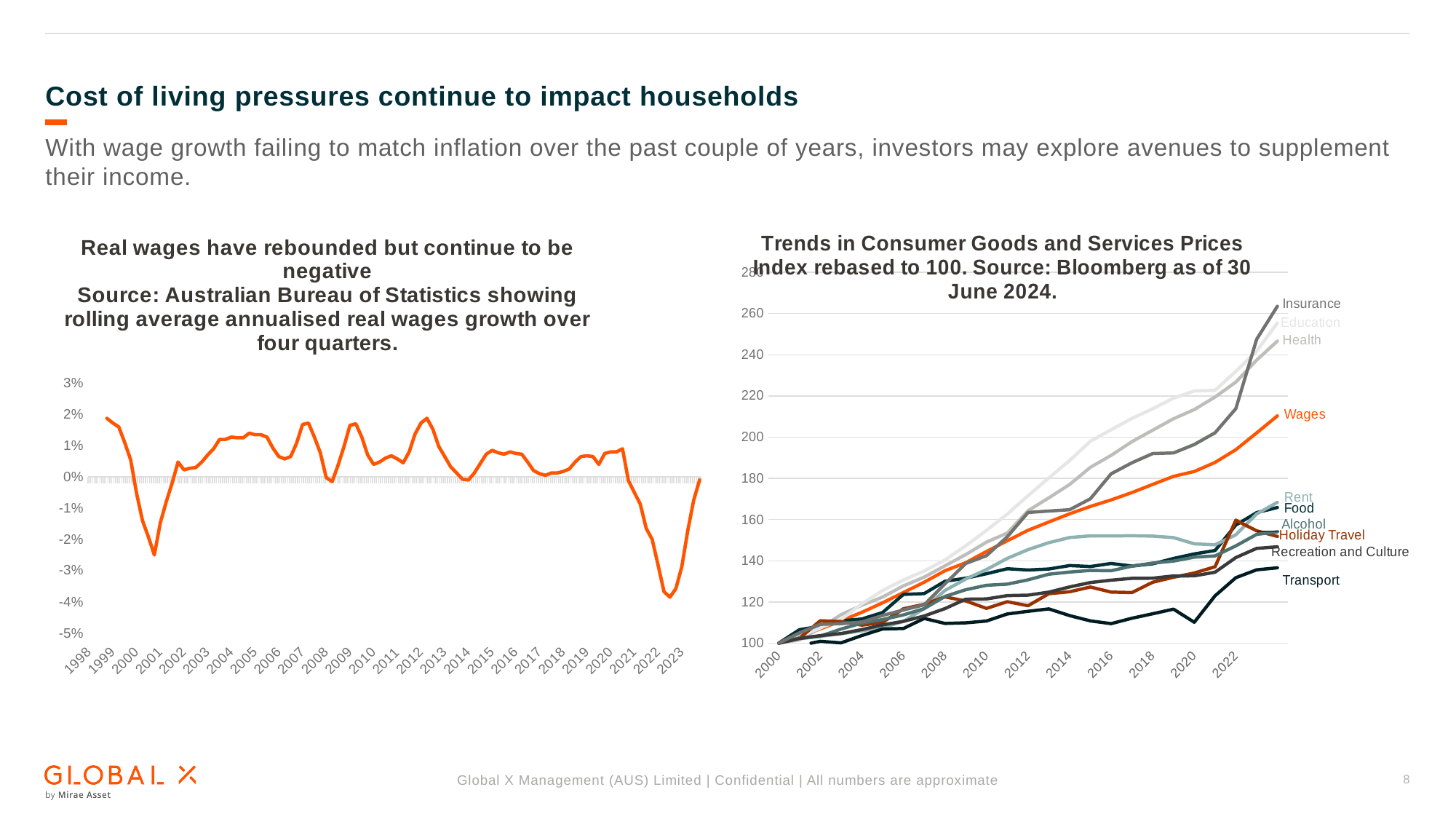
In the right-hand chart, how many series are labelled at the ends of the lines? 10 In the left-hand chart on real wages, in which year does the line reach its lowest point? 2023 In the right-hand chart, what index value do all series start at in 2000? 100 In the left-hand chart on real wages, is the lowest value greater or less than -3%? less In the right-hand chart, is the final value for Wages greater or less than 200? greater In the right-hand chart, which series has the highest index value at the end of the period? Insurance In the right-hand chart, which series has the lowest index value at the end of the period? Transport In the right-hand chart, is the final value for Transport greater or less than 140? less In the right-hand chart, which is larger at the end of the period, Wages or Rent? Wages What kind of chart is the 'Trends in Consumer Goods and Services Prices' chart on the right? line chart In the right-hand chart, what colour is the Wages line? orange